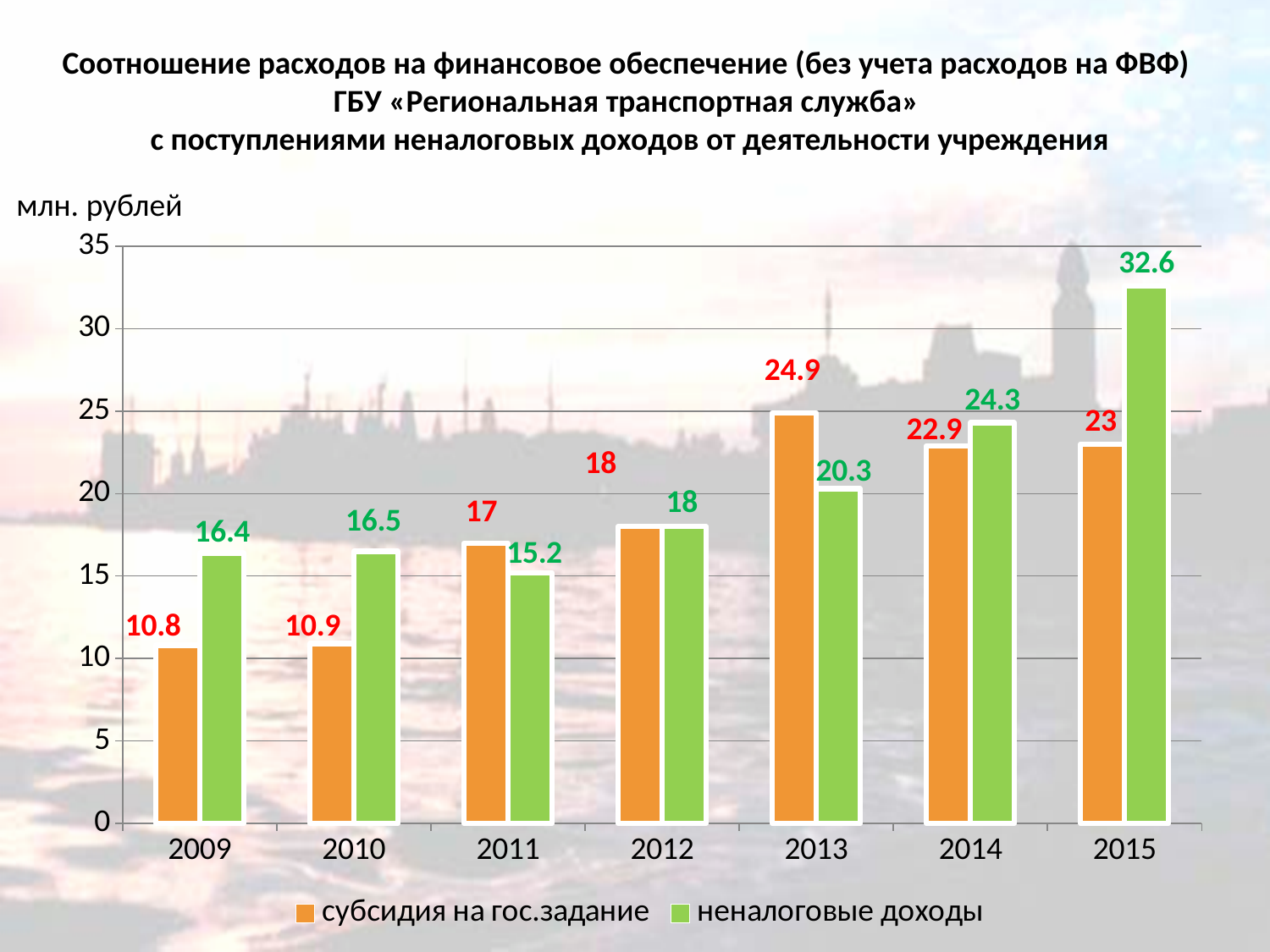
What is the value of субсидия на гос.задание in 2013? 24.9 In which year is неналоговые доходы highest? 2015 Is the value of субсидия на гос.задание in 2014 greater or less than 20? greater How many series does the legend list? 2 What unit is indicated above the chart's vertical axis? млн. рублей What is the value of неналоговые доходы in 2015? 32.6 How many years are shown on the x axis? 7 What is the value of неналоговые доходы in 2011? 15.2 What kind of chart is shown on the slide? bar chart In which year is субсидия на гос.задание lowest? 2009 Which is larger in 2013: субсидия на гос.задание or неналоговые доходы? субсидия на гос.задание What is the difference between неналоговые доходы and субсидия на гос.задание in 2015? 9.6